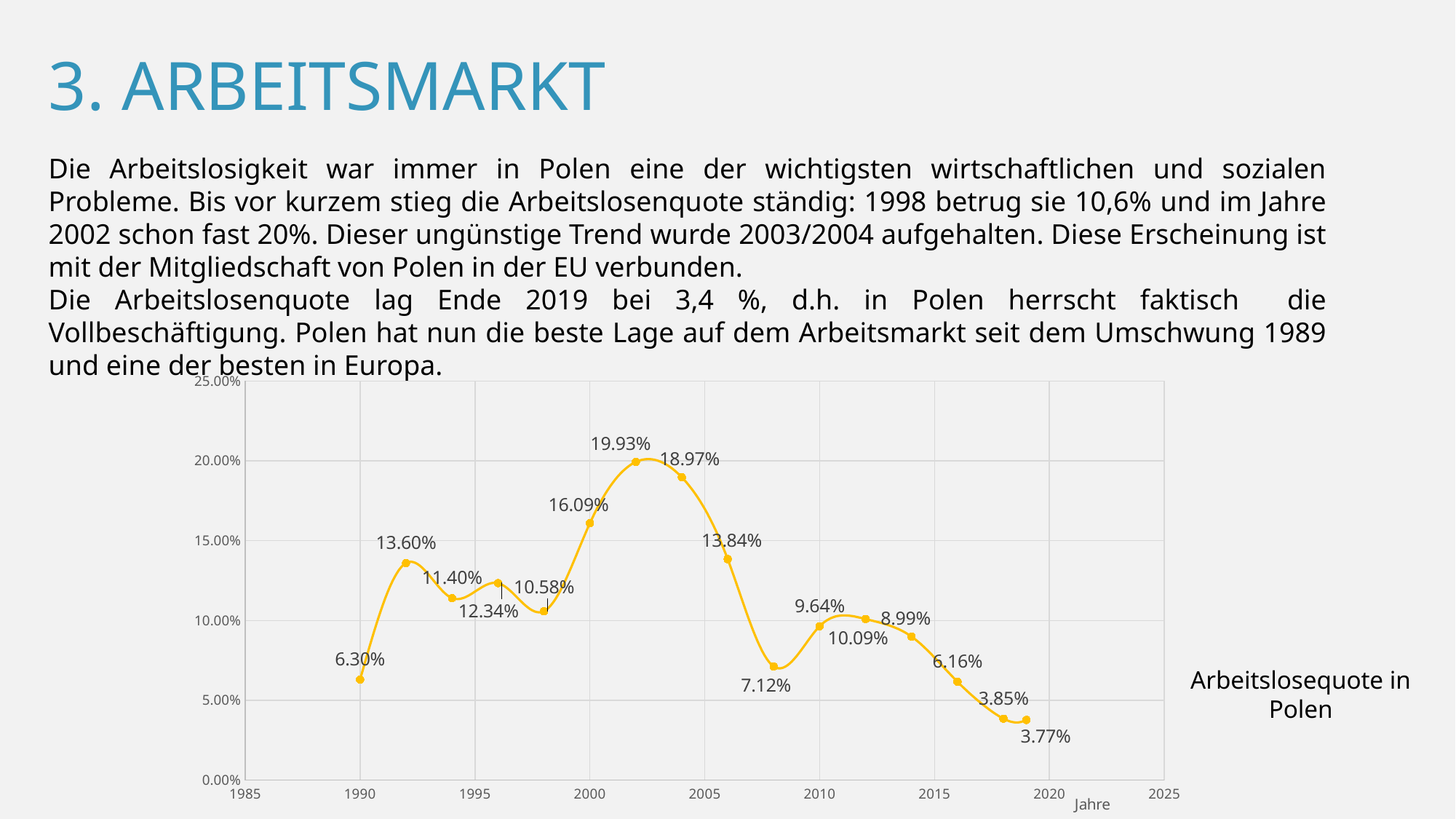
What kind of chart is shown on the slide? line chart What is the label of the x axis? Jahre Is the value for 2000 greater or less than 15.00%? greater What is the unemployment rate value plotted for the year 2010? 9.64% What is the unemployment rate value plotted for the year 2000? 16.09% What is the difference between the values for 2000 and 1990? 9.79% Which is larger, the value for 1990 or the value for 2010? 2010 How many data points are plotted on the line? 16 What is the highest unemployment rate value labelled on the chart? 19.93% What is the lowest unemployment rate value labelled on the chart? 3.77% What is the difference between the highest labelled value (19.93%) and the lowest labelled value (3.77%)? 16.16% What is the unemployment rate value plotted for the year 1990? 6.30%